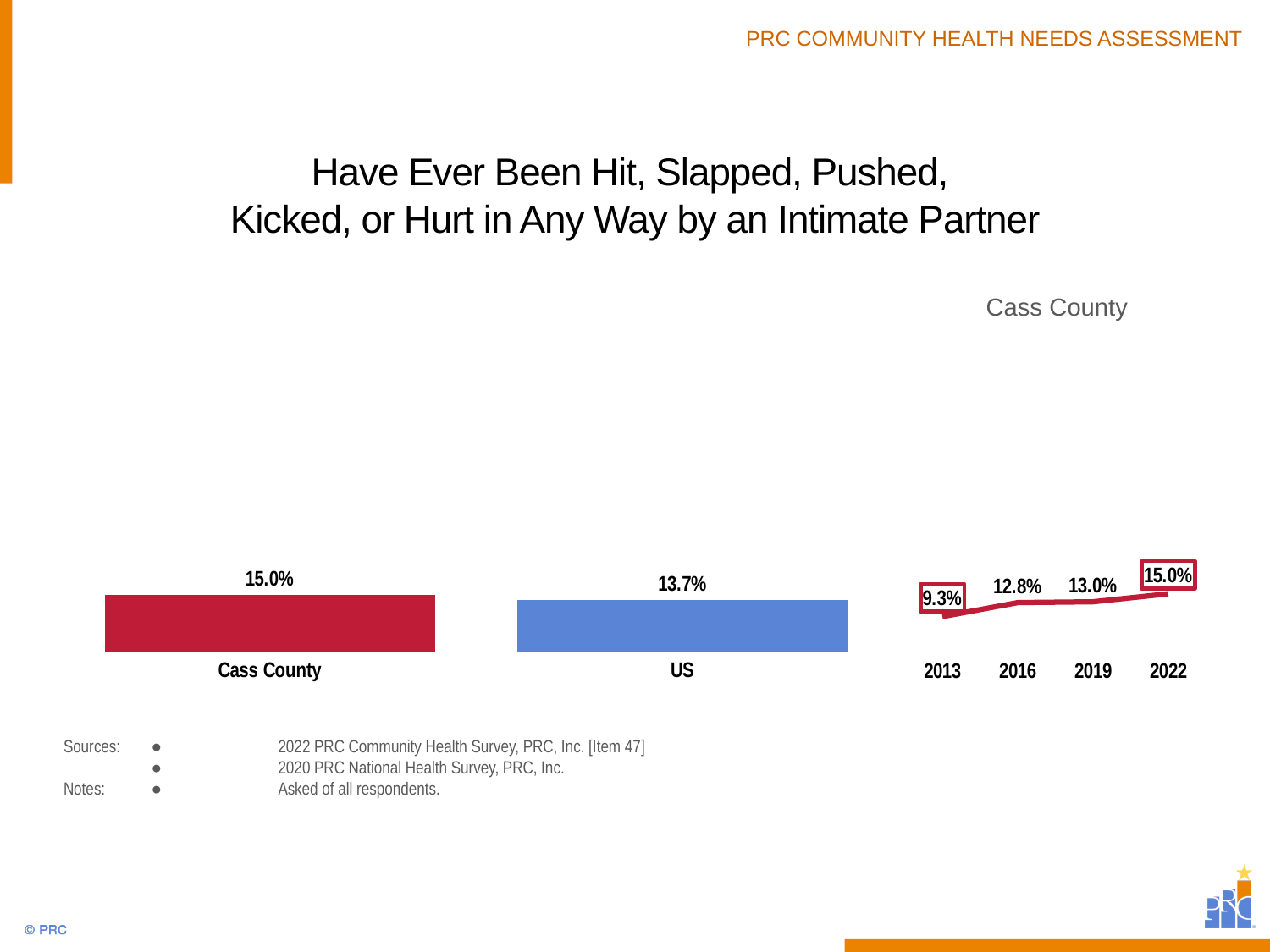
In the Cass County trend chart on the right, what is the value for 2013? 9.3% In the Cass County trend chart on the right, what is the value for 2019? 13.0% In the Cass County trend chart on the right, which year has the lowest value? 2013 In the bar chart on the left, how many categories are shown? 2 In the Cass County trend chart on the right, what is the difference between the 2022 value and the 2013 value? 5.7% In the Cass County trend chart on the right, what is the value for 2016? 12.8% In the bar chart on the left, which category has the higher value, Cass County or US? Cass County In the bar chart on the left, what is the value for Cass County? 15.0% In the bar chart on the left, what is the difference between the Cass County value and the US value? 1.3% In the bar chart on the left, what is the value for US? 13.7% In the Cass County trend chart on the right, do the values rise or fall from 2013 to 2022? Rise What kind of chart is the chart on the left comparing Cass County and US? Bar chart